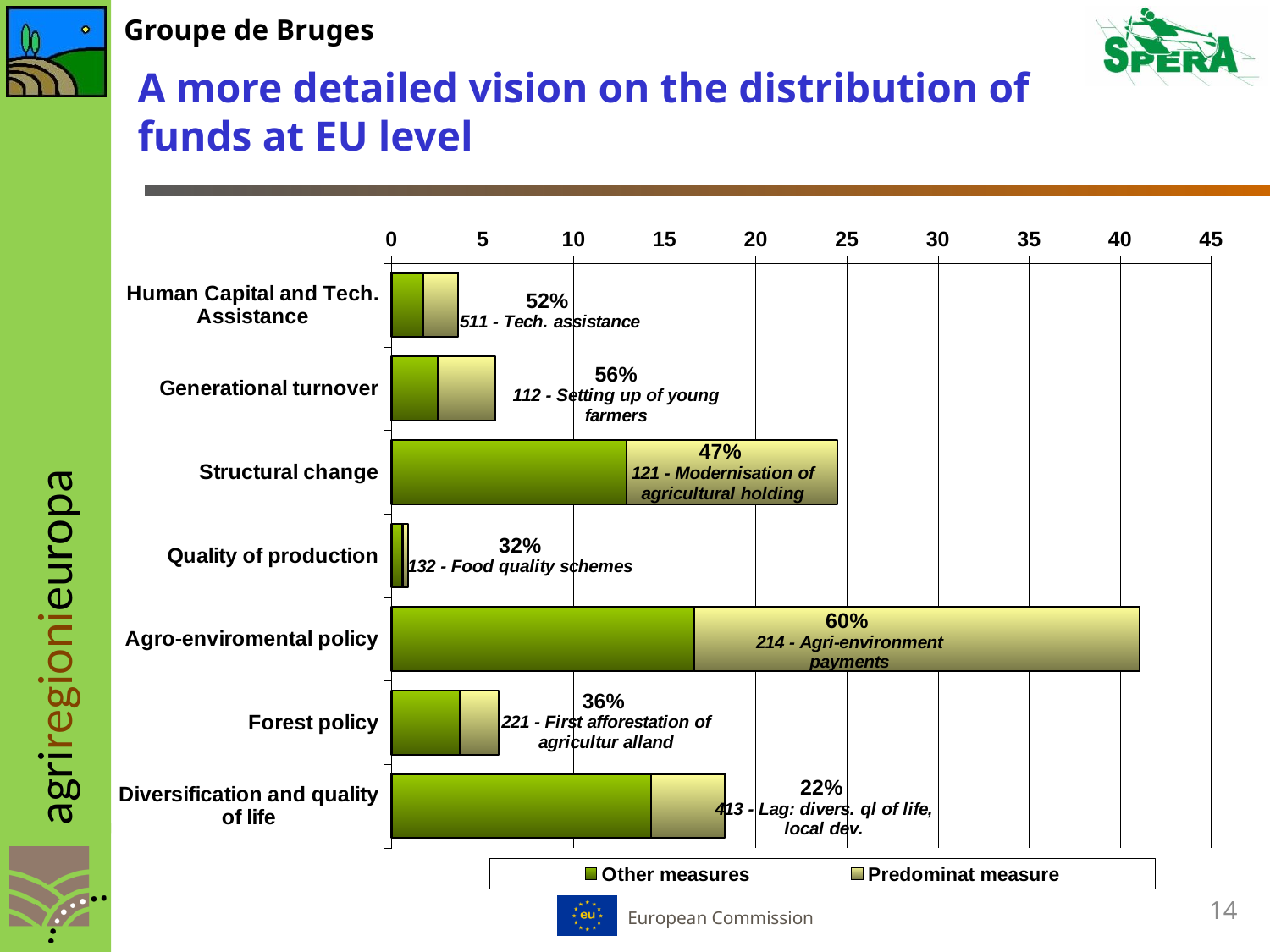
How many policy categories are plotted on the chart? 7 Which measure is named as the predominant measure for Agro-enviromental policy? 214 - Agri-environment payments Is the total bar length for Quality of production greater or less than 5? less Which total bar is longer, Structural change or Diversification and quality of life? Structural change Which category has the longest total bar? Agro-enviromental policy Is the total bar length for Agro-enviromental policy greater or less than 40? greater What percentage is printed next to the Structural change bar? 47% Which category has the shortest total bar? Quality of production What kind of chart is shown on the slide? bar chart How many series does the legend list? 2 What is the difference in percentage points between the percentage printed for Agro-enviromental policy and the one printed for Diversification and quality of life? 38 What percentage is printed next to the Forest policy bar? 36%